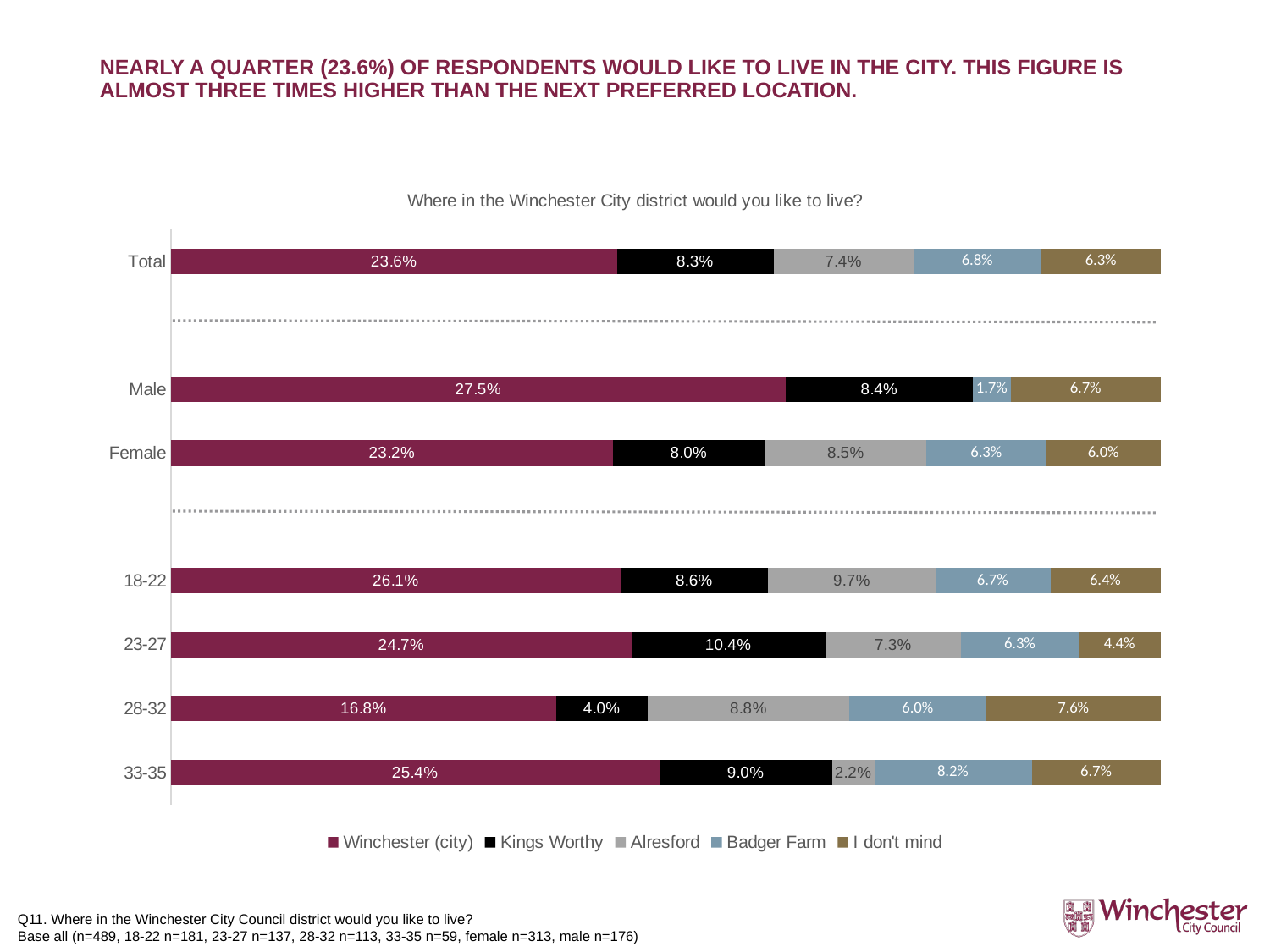
Which category has the highest Winchester (city) value? Male What is the 'I don't mind' value for the 28-32 age group? 7.6% How many series does the legend list? 5 Which category has the highest Kings Worthy value? 23-27 For the Total bar, what is the difference between the Winchester (city) value and the Kings Worthy value? 15.3 percentage points What is the total of all labelled segments in the Total bar? 52.4% What percentage of Total respondents would like to live in Winchester (city)? 23.6% Which category has the lowest Winchester (city) value? 28-32 What is the Kings Worthy value for the 23-27 age group? 10.4% What kind of chart is shown on the slide? Stacked bar chart Which has the larger Alresford value: 18-22 or Female? 18-22 How many categories (bars) are shown on the chart? 7